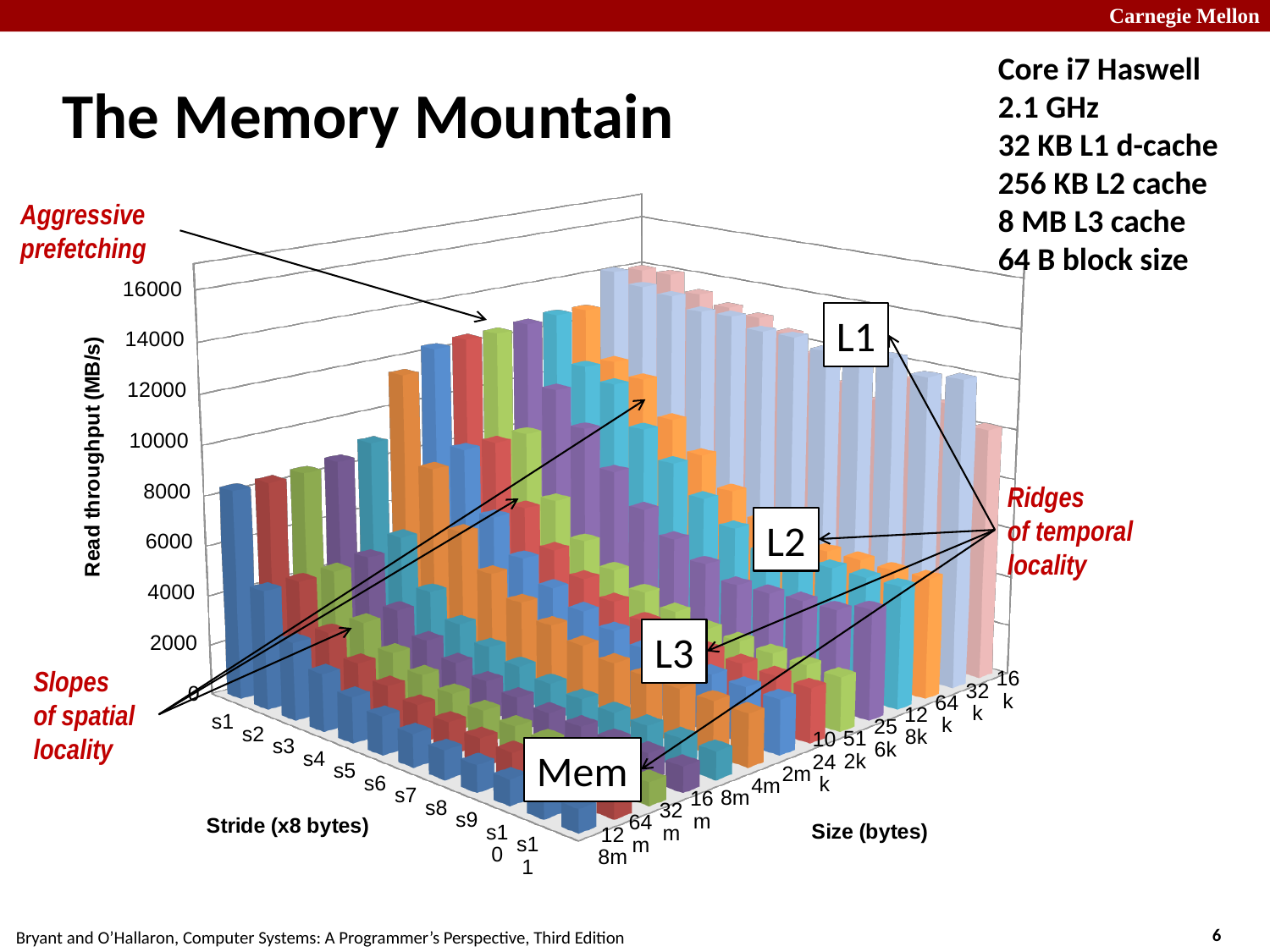
Is the read throughput for size 16k at stride s1 greater or less than 12000? greater How many stride categories (s1 through s11) are shown on the stride axis? 11 What kind of chart is shown on the slide? 3D bar chart How many size categories are shown on the Size (bytes) axis? 14 Which size category has the lowest read throughput at stride s11: 16k or 128m? 128m Which stride has the higher read throughput for size 128m: s1 or s11? s1 What is the highest tick value shown on the Read throughput axis? 16000 For a fixed size, does read throughput rise or fall as the stride increases from s1 to s11? fall Which size category has the highest read throughput at stride s1: 16k or 128m? 16k Is the read throughput for size 128m at stride s11 greater or less than 4000? less What is the label of the vertical axis of the chart? Read throughput (MB/s) What is the title of the chart on the slide? The Memory Mountain